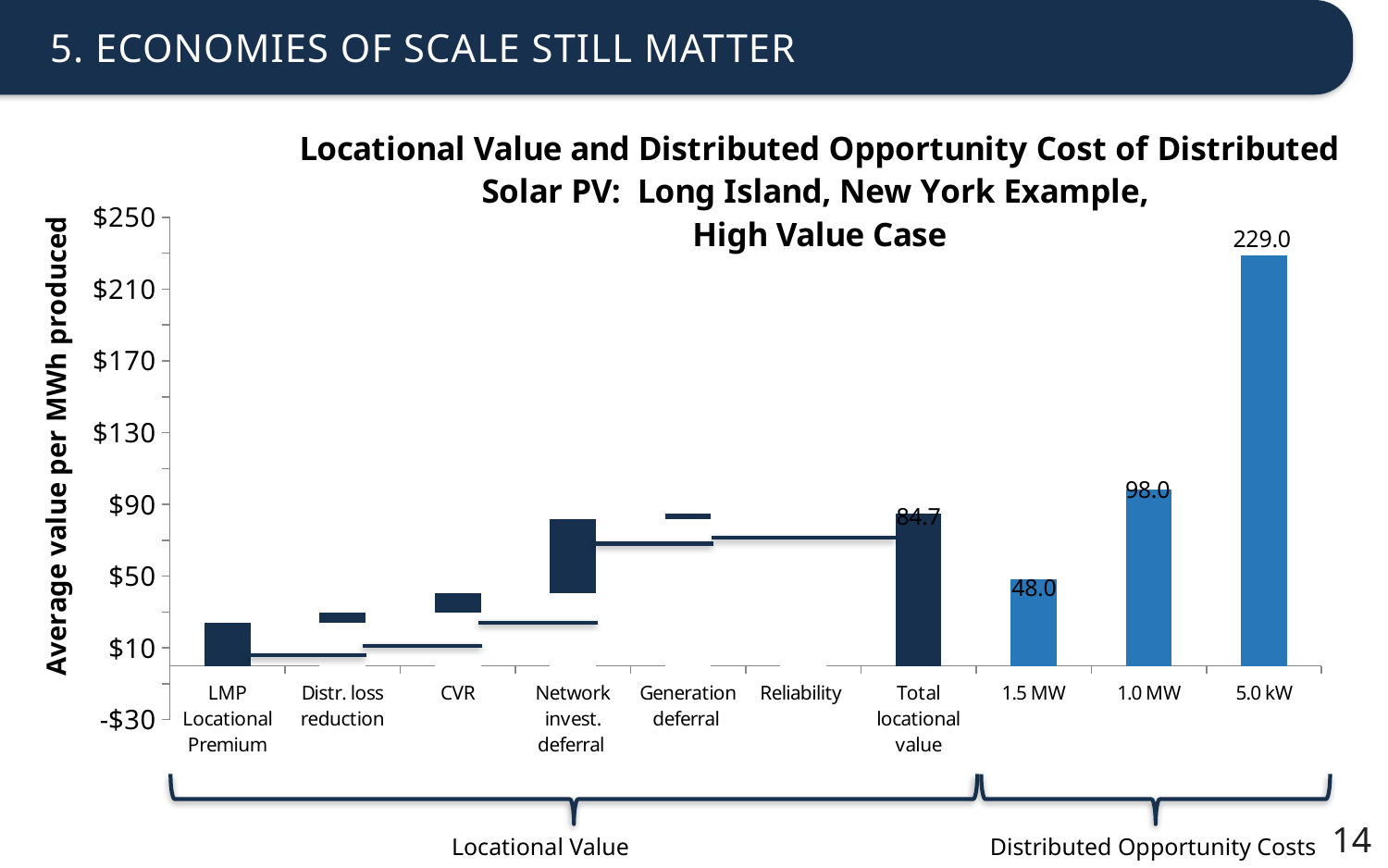
What is the title of the vertical axis? Average value per MWh produced What kind of chart is shown on the slide? bar chart Which is larger, the value for 1.0 MW or the Total locational value? 1.0 MW Is the value for LMP Locational Premium greater or less than $50? less What is the difference between the values for 5.0 kW and 1.0 MW? 131.0 What is the value for 5.0 kW? 229.0 What is the value for 1.0 MW? 98.0 What is the value labelled on the Total locational value bar? 84.7 How many categories are shown on the x axis? 10 What is the value for 1.5 MW? 48.0 What is the difference between the values for 1.0 MW and 1.5 MW? 50.0 Which category has the highest value on the chart? 5.0 kW